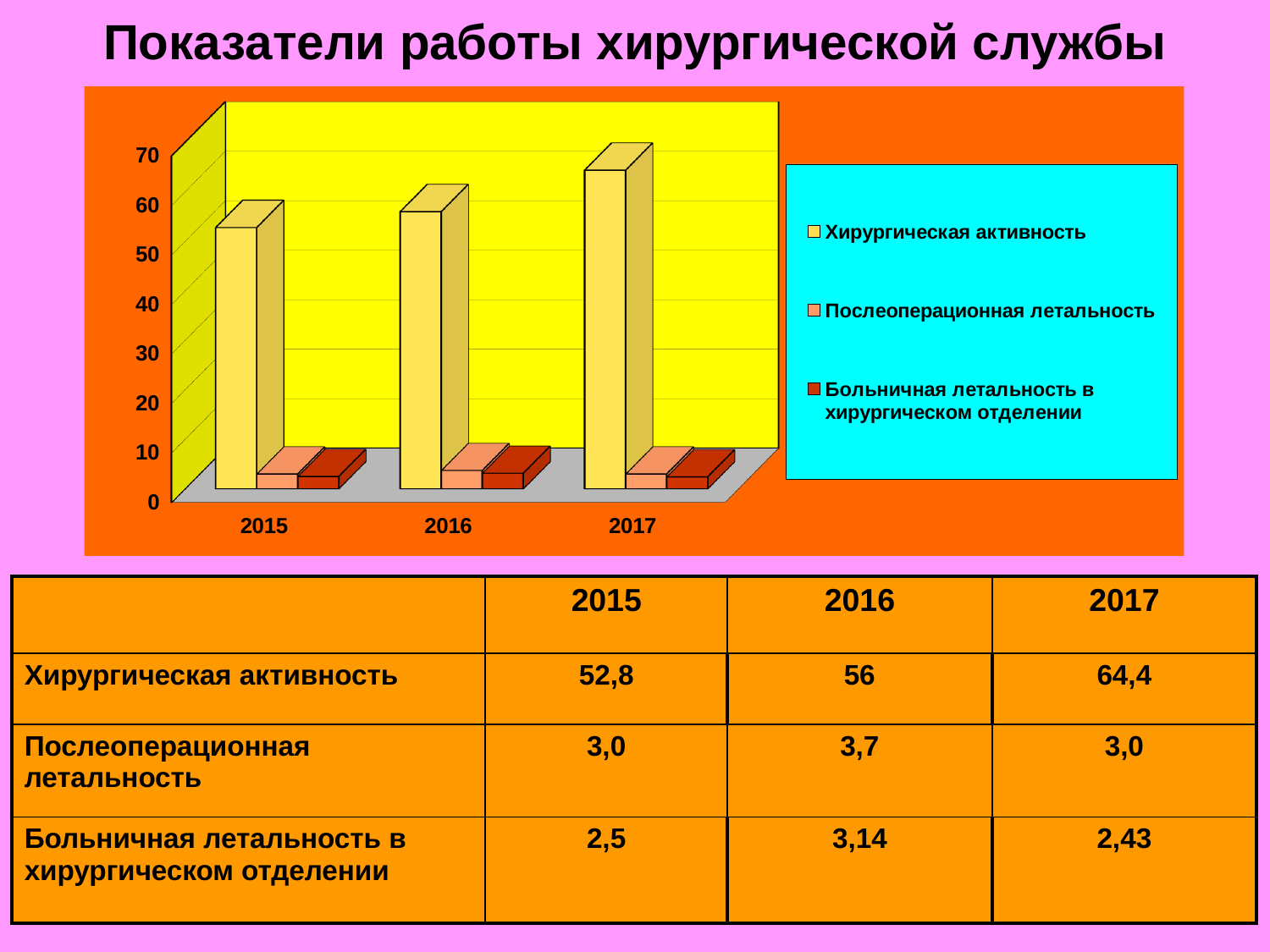
How many years are shown on the x axis of the chart? 3 In which year is Хирургическая активность lowest? 2015 What is the difference between Хирургическая активность in 2017 and in 2015? 11,6 What is the value of Больничная летальность в хирургическом отделении for 2015? 2,5 Which is larger: Хирургическая активность in 2016 or in 2015? 2016 What is the value of Послеоперационная летальность for 2016? 3,7 In which year is Хирургическая активность highest? 2017 Does Хирургическая активность rise or fall from 2015 to 2017? rise What kind of chart is shown on the slide? bar chart What is the value of Хирургическая активность for 2017? 64,4 How many series does the chart legend list? 3 Is the value for Хирургическая активность in 2017 greater or less than 60? greater